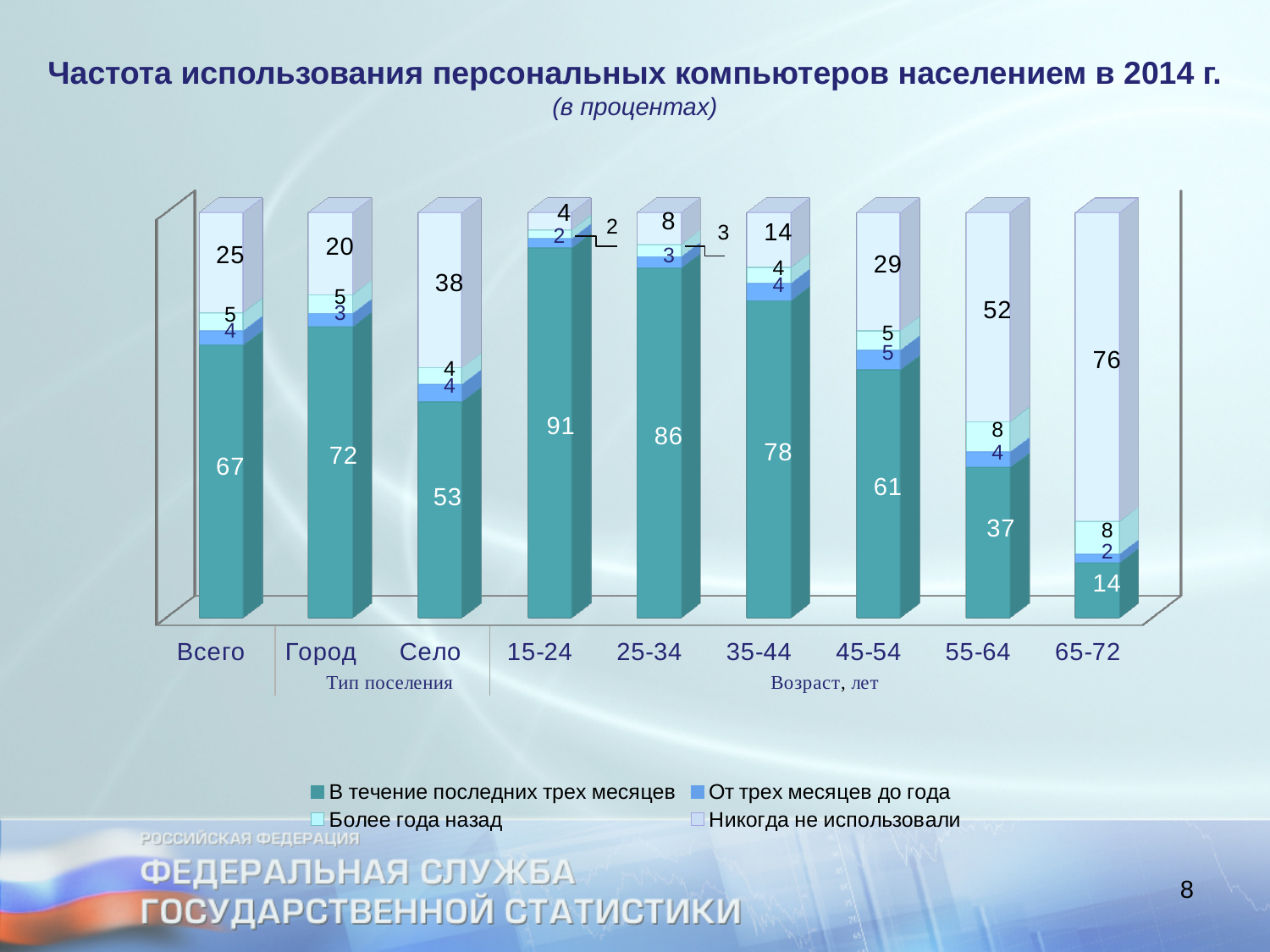
Across the age groups from 15-24 to 65-72, does the value of "В течение последних трех месяцев" rise or fall? Fall What is the value of "Никогда не использовали" for the 55-64 age group? 52 What kind of chart is shown on the slide? Stacked bar chart Which has a larger "Никогда не использовали" value: the 45-54 age group or the 35-44 age group? 45-54 What is the value of "Никогда не использовали" for the "Село" category? 38 Which category has the highest value for "В течение последних трех месяцев"? 15-24 Which category has the lowest value for "Никогда не использовали"? 15-24 What is the value of "В течение последних трех месяцев" for the "Всего" category? 67 How many categories are shown on the x axis? 9 What is the value of "В течение последних трех месяцев" for the 65-72 age group? 14 What is the difference between the "В течение последних трех месяцев" values for "Город" and "Село"? 19 How many series does the legend list? 4